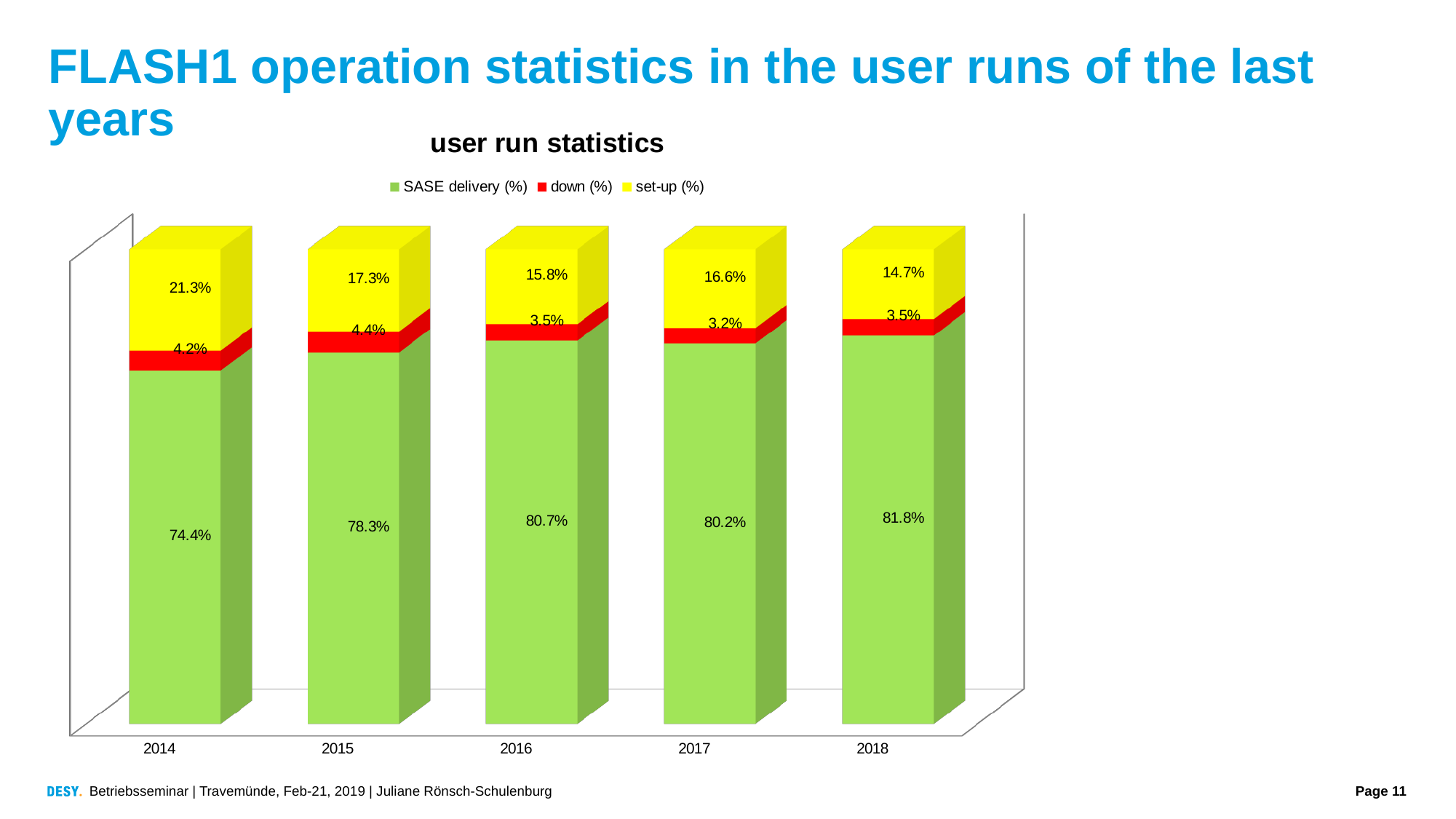
Which year has the highest SASE delivery (%)? 2018 What kind of chart is shown? Stacked bar chart What is the down (%) value for 2017? 3.2% What is the set-up (%) value for 2014? 21.3% Is the set-up (%) value larger for 2016 or 2017? 2017 Which year has the highest down (%)? 2015 Which year has the lowest set-up (%)? 2018 How many years are shown on the x axis? 5 What is the title of the chart? user run statistics What is the SASE delivery (%) value for 2018? 81.8% What is the difference between the SASE delivery (%) values for 2018 and 2014? 7.4% How many series does the legend list? 3